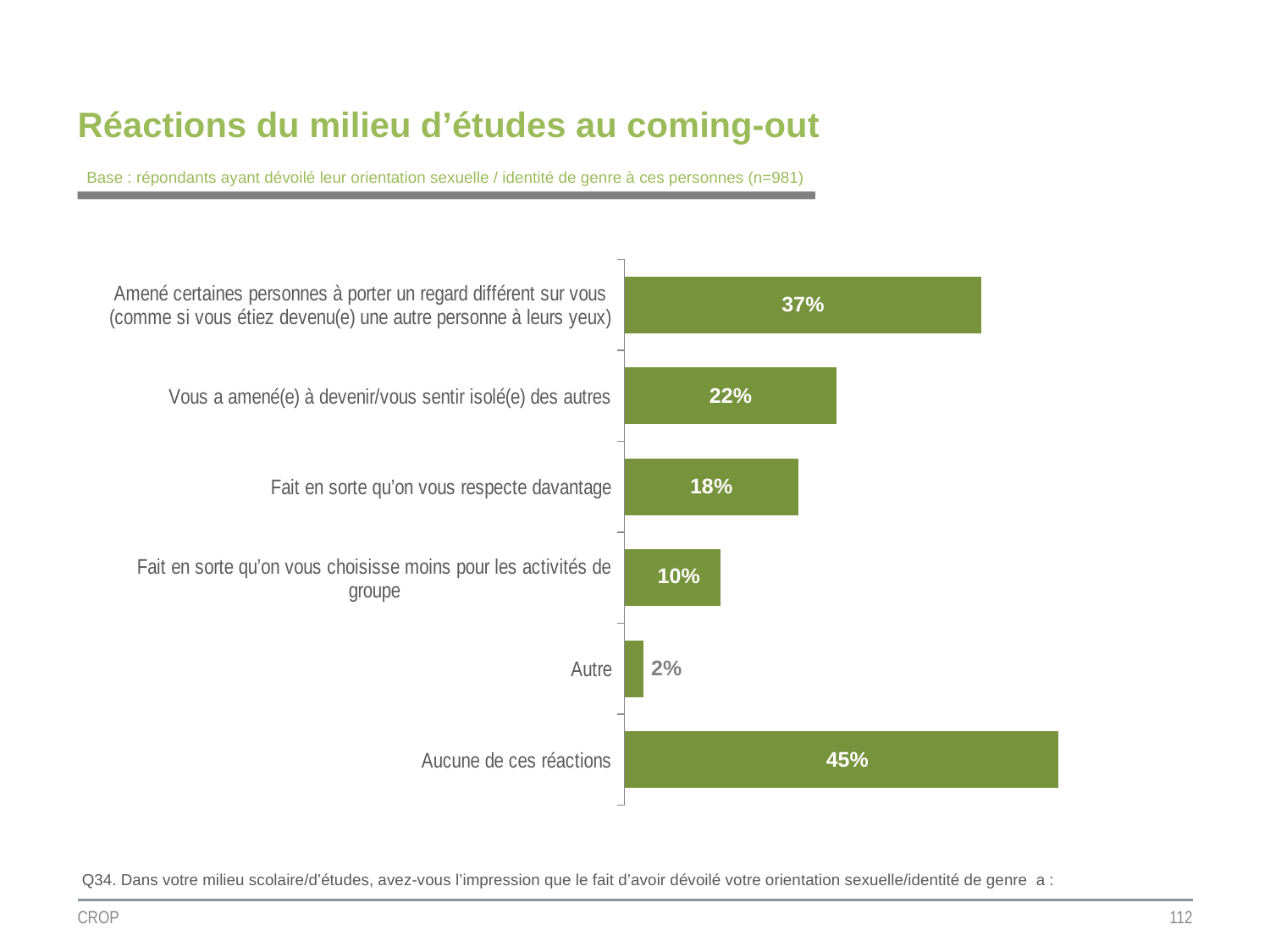
What is the value for "Autre"? 2% What kind of chart is shown on the slide? Bar chart Which category has the lowest value? Autre What is the difference between the value for "Vous a amené(e) à devenir/vous sentir isolé(e) des autres" and the value for "Fait en sorte qu'on vous choisisse moins pour les activités de groupe"? 12% What is the value for "Vous a amené(e) à devenir/vous sentir isolé(e) des autres"? 22% Which is larger: the value for "Fait en sorte qu'on vous respecte davantage" or the value for "Fait en sorte qu'on vous choisisse moins pour les activités de groupe"? Fait en sorte qu'on vous respecte davantage What is the title of the chart on the slide? Réactions du milieu d'études au coming-out What is the difference between the value for "Aucune de ces réactions" and the value for "Amené certaines personnes à porter un regard différent sur vous"? 8% What is the value for "Fait en sorte qu'on vous respecte davantage"? 18% How many categories are shown in the chart? 6 Which category has the highest value? Aucune de ces réactions What is the value for "Aucune de ces réactions"? 45%